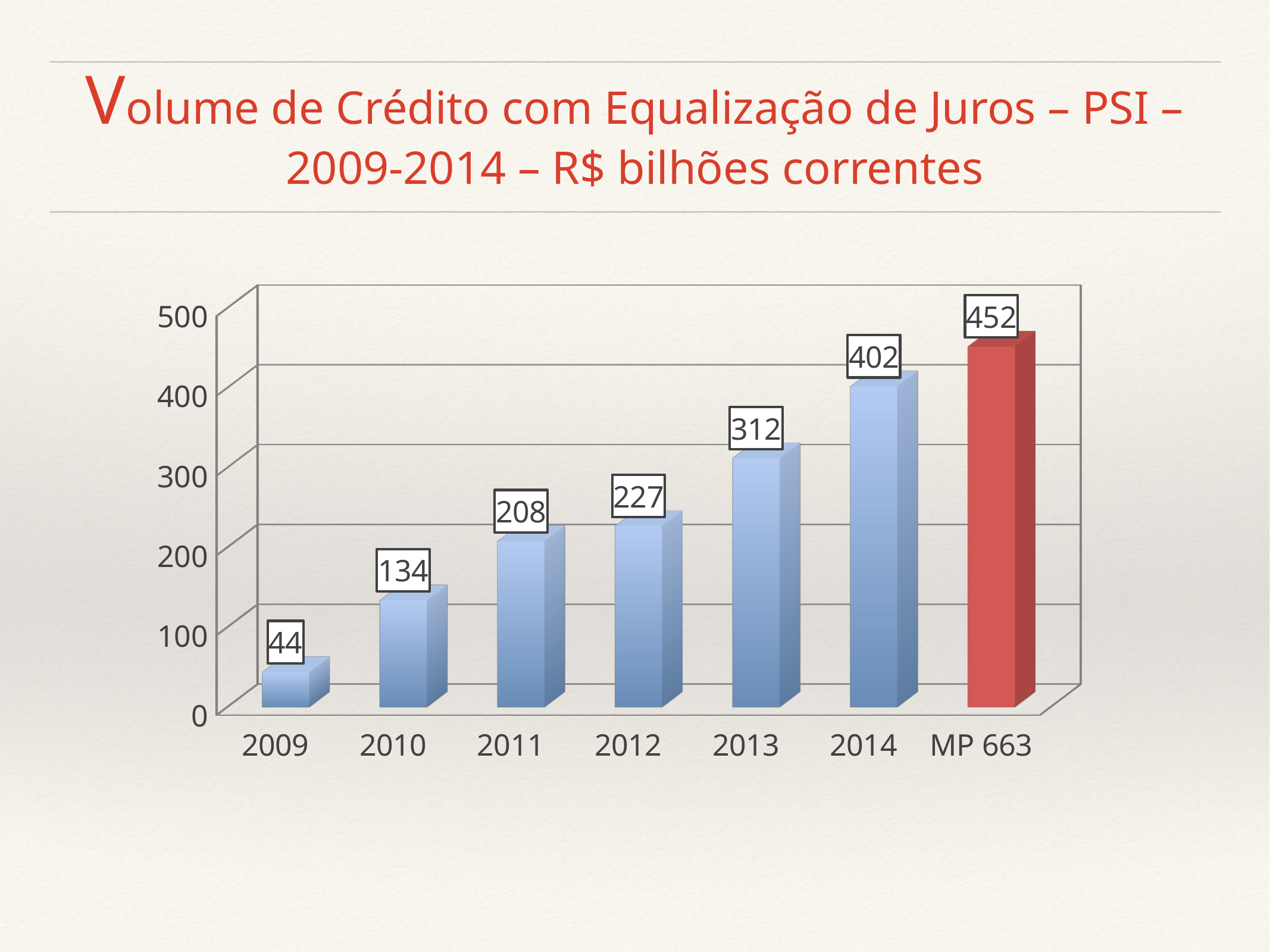
Is the value for 2013 greater or less than 300? greater Do the values rise or fall from 2009 to 2014? rise Which category has the lowest value? 2009 What is the value for MP 663? 452 How many categories are shown on the x axis? 7 What is the value for 2012? 227 Which is larger, the value for 2011 or the value for 2012? 2012 What is the value for 2009? 44 What is the difference between the values for MP 663 and 2014? 50 Which category has the highest value? MP 663 What kind of chart is shown on the slide? bar chart What is the difference between the values for 2014 and 2013? 90